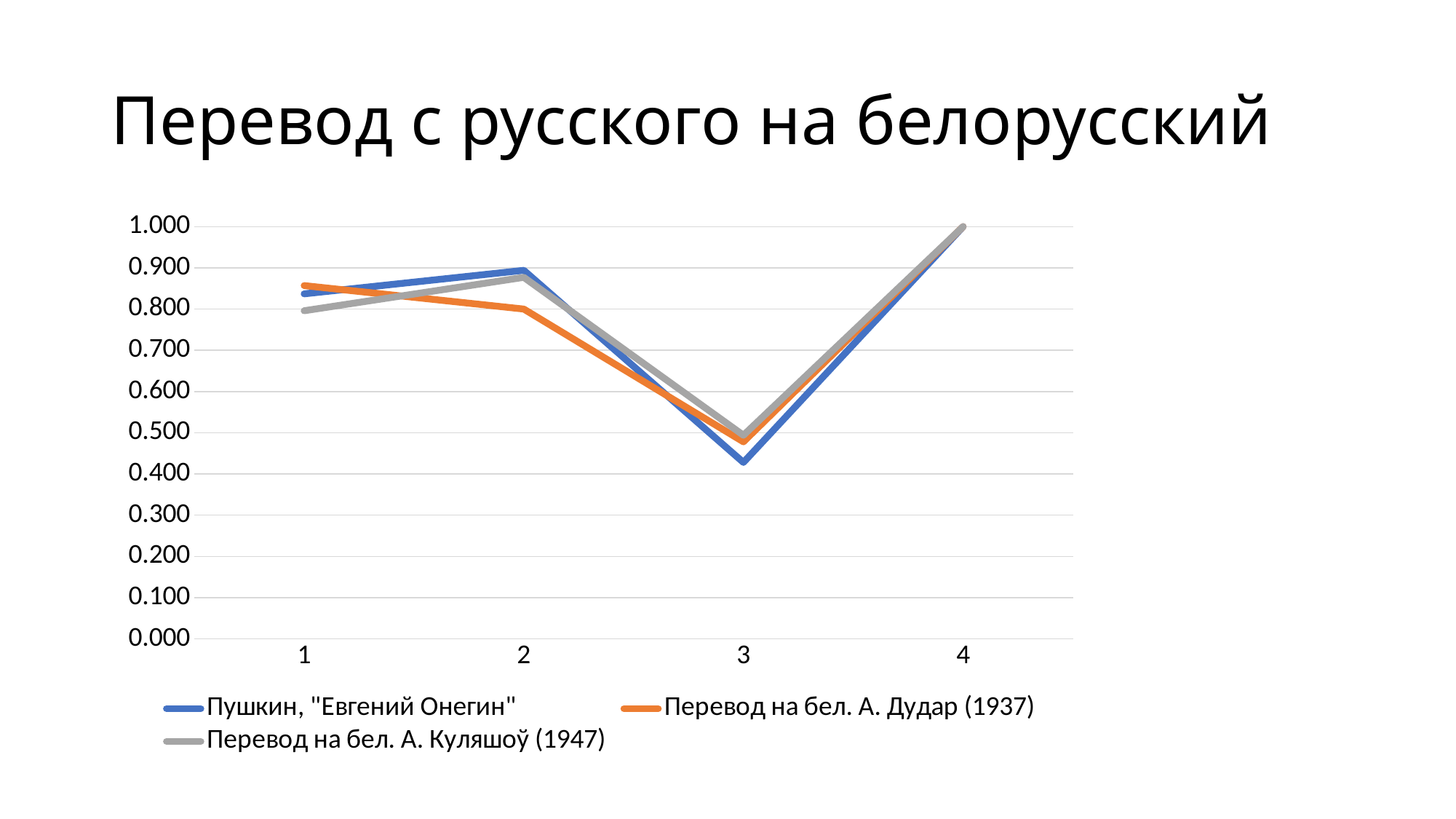
Do the values of the series Перевод на бел. А. Дудар (1937) rise or fall from point 2 to point 3? fall At point 1, which series has the larger value: Перевод на бел. А. Дудар (1937) or Перевод на бел. А. Куляшоў (1947)? Перевод на бел. А. Дудар (1937) Is the value for Пушкин, "Евгений Онегин" at point 3 greater or less than 0.500? less What is the value of the series Пушкин, "Евгений Онегин" at point 4? 1.000 At point 3, which series has the larger value: Пушкин, "Евгений Онегин" or Перевод на бел. А. Куляшоў (1947)? Перевод на бел. А. Куляшоў (1947) How many points are plotted along the x axis for each series? 4 At which x-axis point does the series Пушкин, "Евгений Онегин" reach its lowest value? 3 What kind of chart is shown on the slide? line chart At which x-axis point does the series Перевод на бел. А. Дудар (1937) reach its highest value? 4 How many series does the legend list? 3 What is the title of the slide? Перевод с русского на белорусский Is the value for Перевод на бел. А. Куляшоў (1947) at point 2 greater or less than 0.800? greater